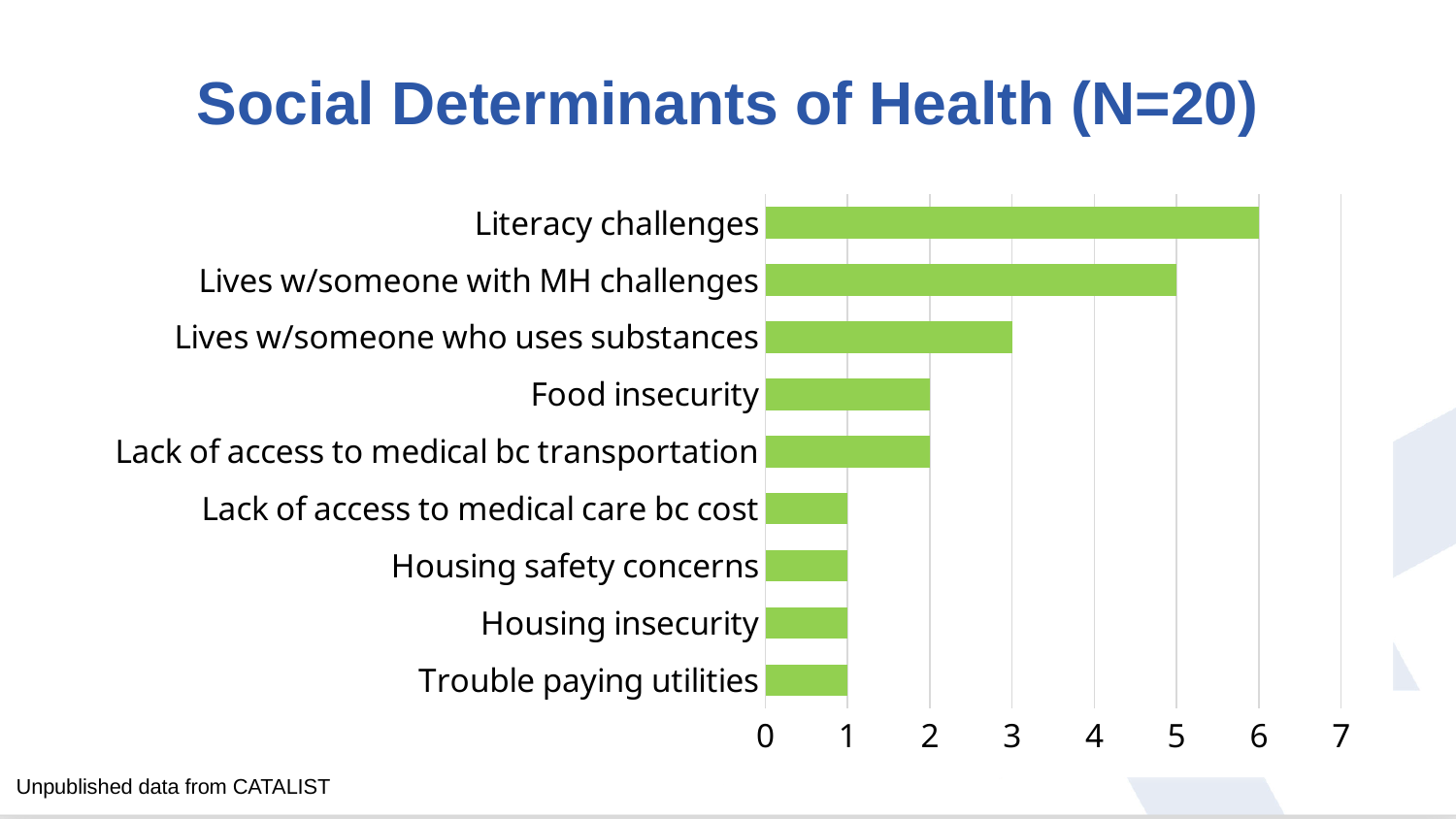
Is the value for Literacy challenges greater or less than 4? greater How many categories are shown in the chart? 9 What is the value for Housing insecurity? 1 Which category has the highest value? Literacy challenges What is the difference between the values for Literacy challenges and Lives w/someone who uses substances? 3 What is the value for Food insecurity? 2 What is the title of the chart? Social Determinants of Health (N=20) Which is larger, the value for Lives w/someone with MH challenges or the value for Food insecurity? Lives w/someone with MH challenges What kind of chart is shown on the slide? bar chart What is the value for Literacy challenges? 6 What is the value for Lives w/someone who uses substances? 3 What is the value for Lives w/someone with MH challenges? 5